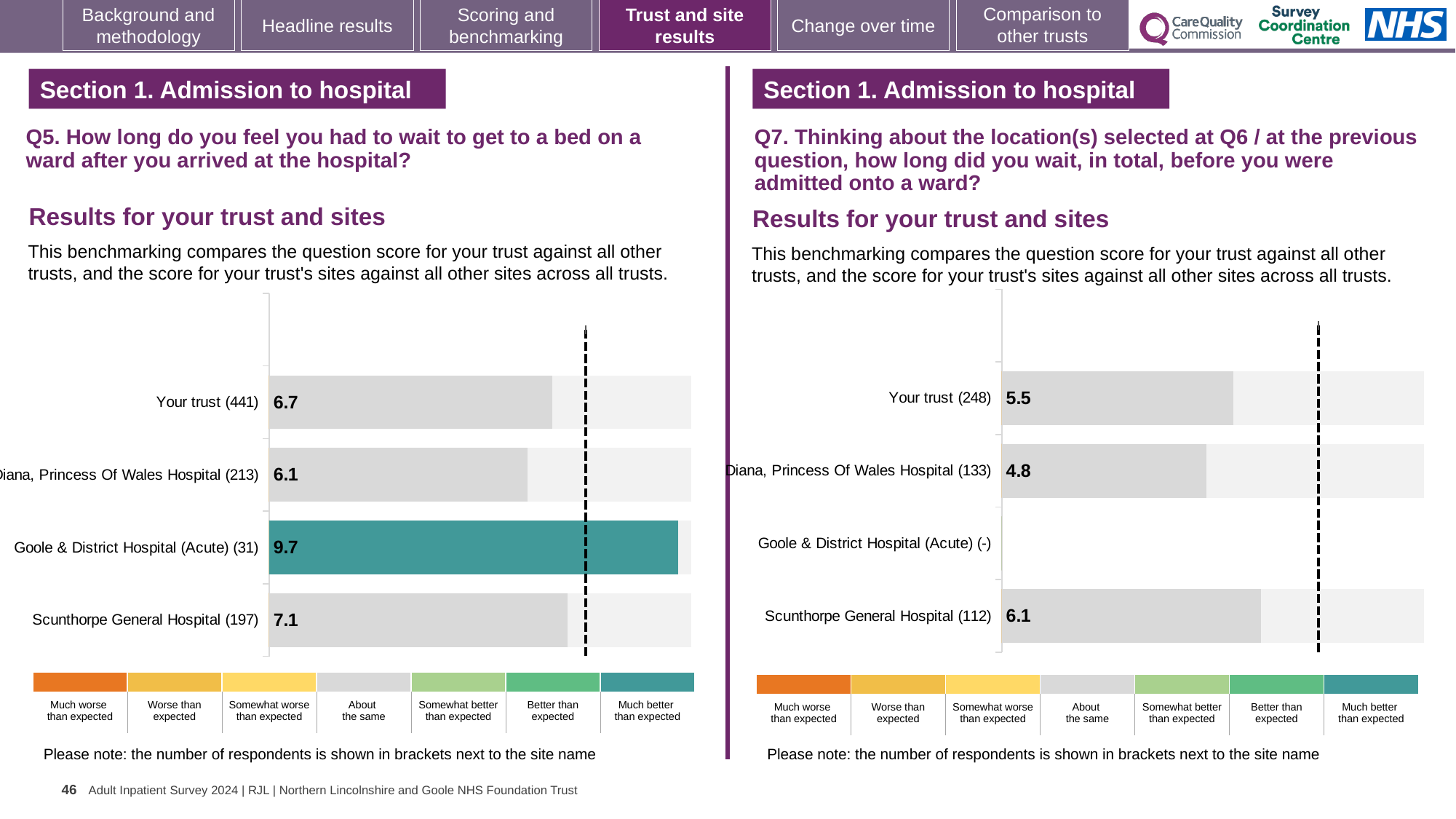
On the Q5 chart (left), which bar is coloured teal rather than grey? Goole & District Hospital (Acute) (31) What kind of chart is used on the Q5 chart (left)? Bar chart On the Q5 chart (left), which has the higher score: Your trust or Scunthorpe General Hospital? Scunthorpe General Hospital On the Q5 chart (left), which site has the highest score? Goole & District Hospital (Acute) (31) On the Q7 chart (right), what is the score for Scunthorpe General Hospital (112)? 6.1 On the Q5 chart (left), what is the score for Goole & District Hospital (Acute) (31)? 9.7 On the Q7 chart (right), what is the score for Your trust (248)? 5.5 On the Q5 chart (left), what is the difference between the scores for Goole & District Hospital (Acute) and Scunthorpe General Hospital? 2.6 On the Q5 chart (left), what is the score for Your trust (441)? 6.7 On the Q5 chart (left), which bar has the lowest score? Diana, Princess Of Wales Hospital (213) On the Q7 chart (right), which site with a score shown has the lowest score? Diana, Princess Of Wales Hospital (133) On the Q7 chart (right), what is the difference between the scores for Scunthorpe General Hospital and Diana, Princess Of Wales Hospital? 1.3